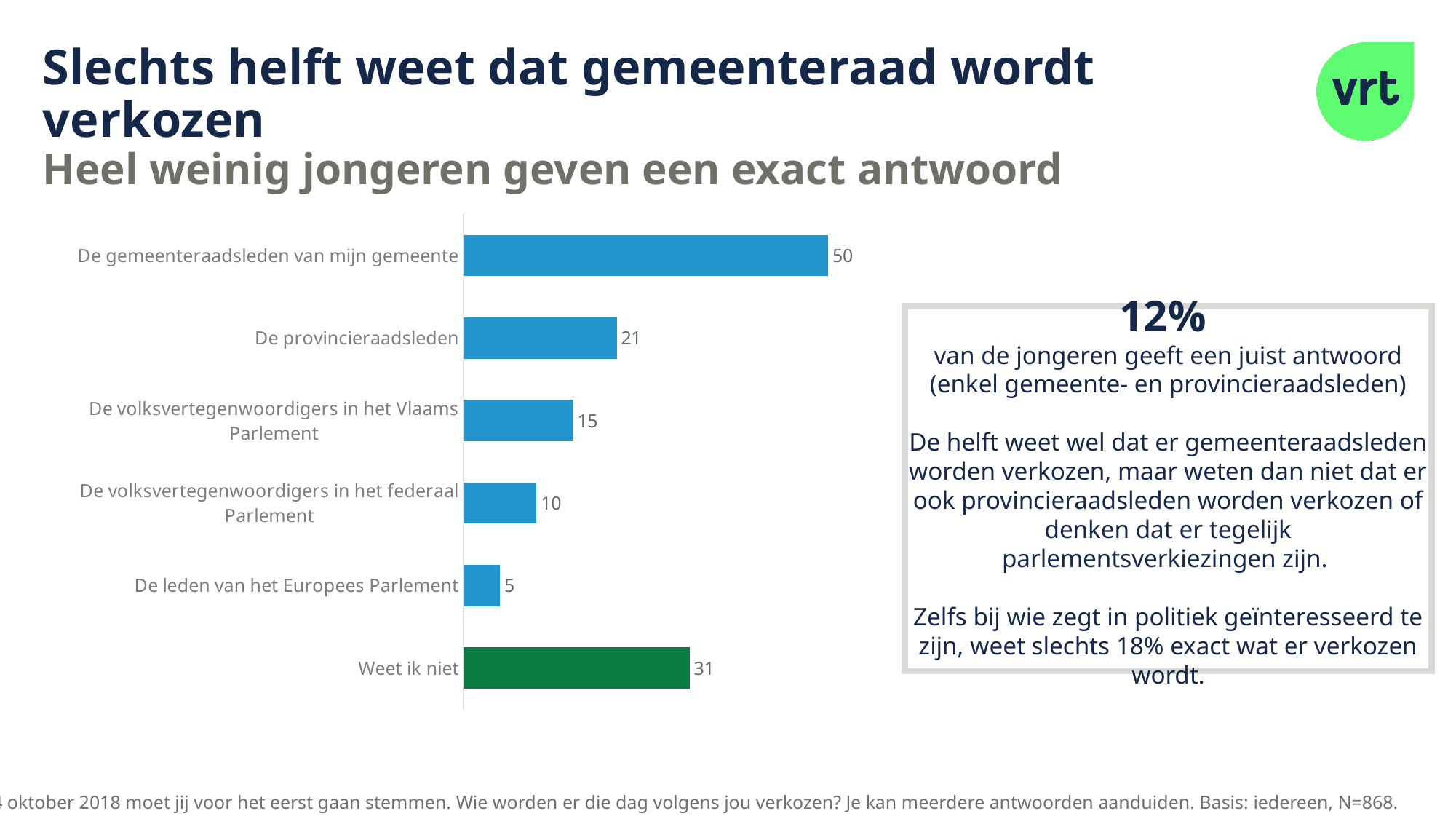
Which bar is shown in a different colour (green) from the others? Weet ik niet What kind of chart is shown on the slide? Bar chart What is the difference between the values for 'Weet ik niet' and 'De volksvertegenwoordigers in het federaal Parlement'? 21 Which category has the highest value? De gemeenteraadsleden van mijn gemeente What is the value for 'Weet ik niet'? 31 Which category has the lowest value? De leden van het Europees Parlement What is the difference between the values for 'De gemeenteraadsleden van mijn gemeente' and 'De provincieraadsleden'? 29 What is the value for 'De gemeenteraadsleden van mijn gemeente'? 50 What is the value for 'De volksvertegenwoordigers in het Vlaams Parlement'? 15 Which is larger: the value for 'Weet ik niet' or the value for 'De provincieraadsleden'? Weet ik niet How many categories are shown in the chart? 6 What is the value for 'De provincieraadsleden'? 21